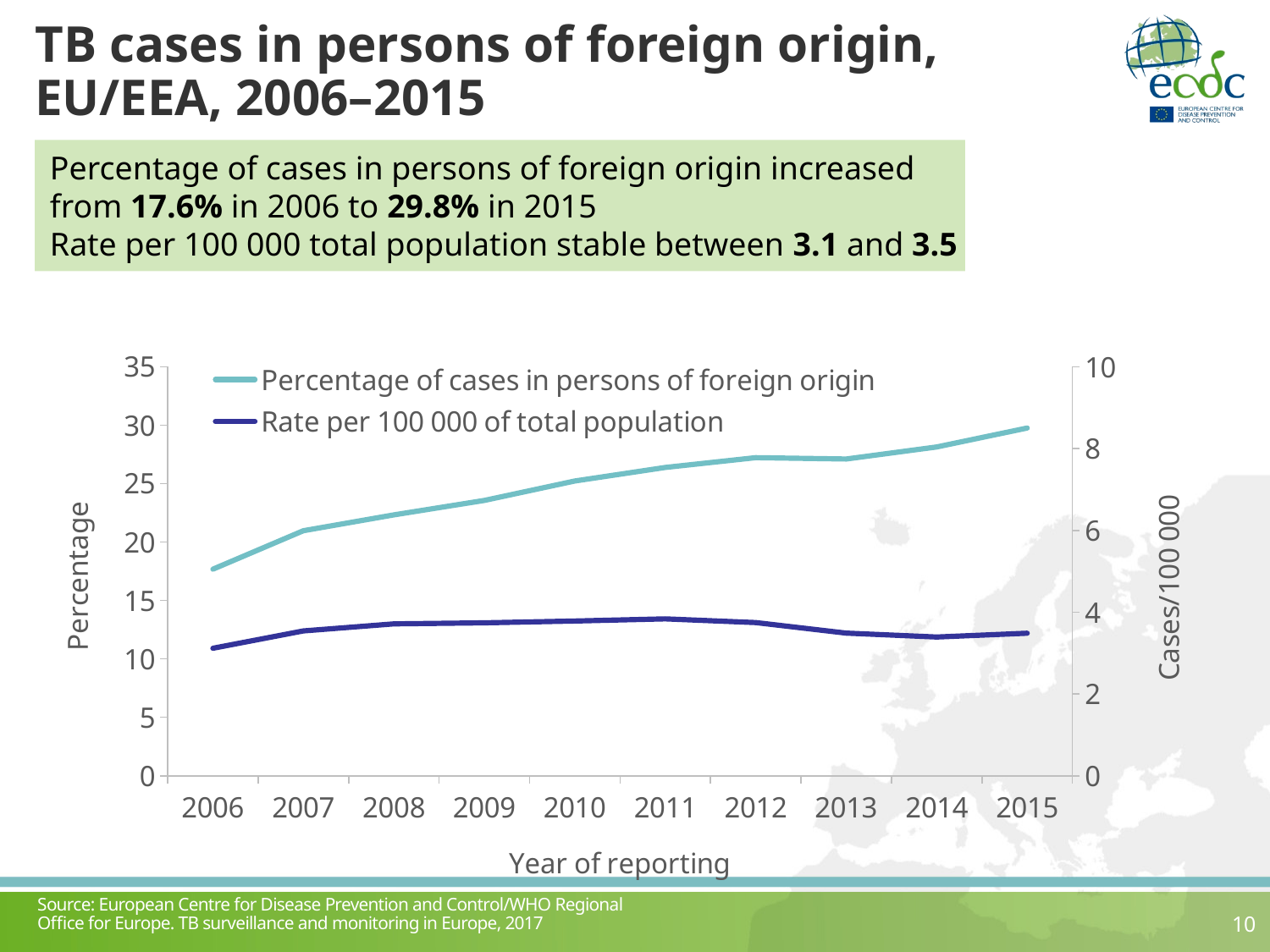
Does the percentage of cases in persons of foreign origin rise or fall from 2006 to 2015? rise How many years of reporting are plotted on the x axis? 10 Is the rate per 100 000 of total population in 2011 greater or less than 4? less How many series does the chart legend list? 2 By how many percentage points did the percentage of cases in persons of foreign origin increase from 2006 to 2015? 12.2 What was the percentage of TB cases in persons of foreign origin in 2006? 17.6% In which year is the percentage of cases in persons of foreign origin lowest? 2006 Is the percentage of cases in persons of foreign origin in 2008 greater or less than 20? greater What was the percentage of TB cases in persons of foreign origin in 2015? 29.8% What kind of chart is shown on the slide? line chart In which year is the percentage of cases in persons of foreign origin highest? 2015 What is the label of the right-hand vertical axis? Cases/100 000